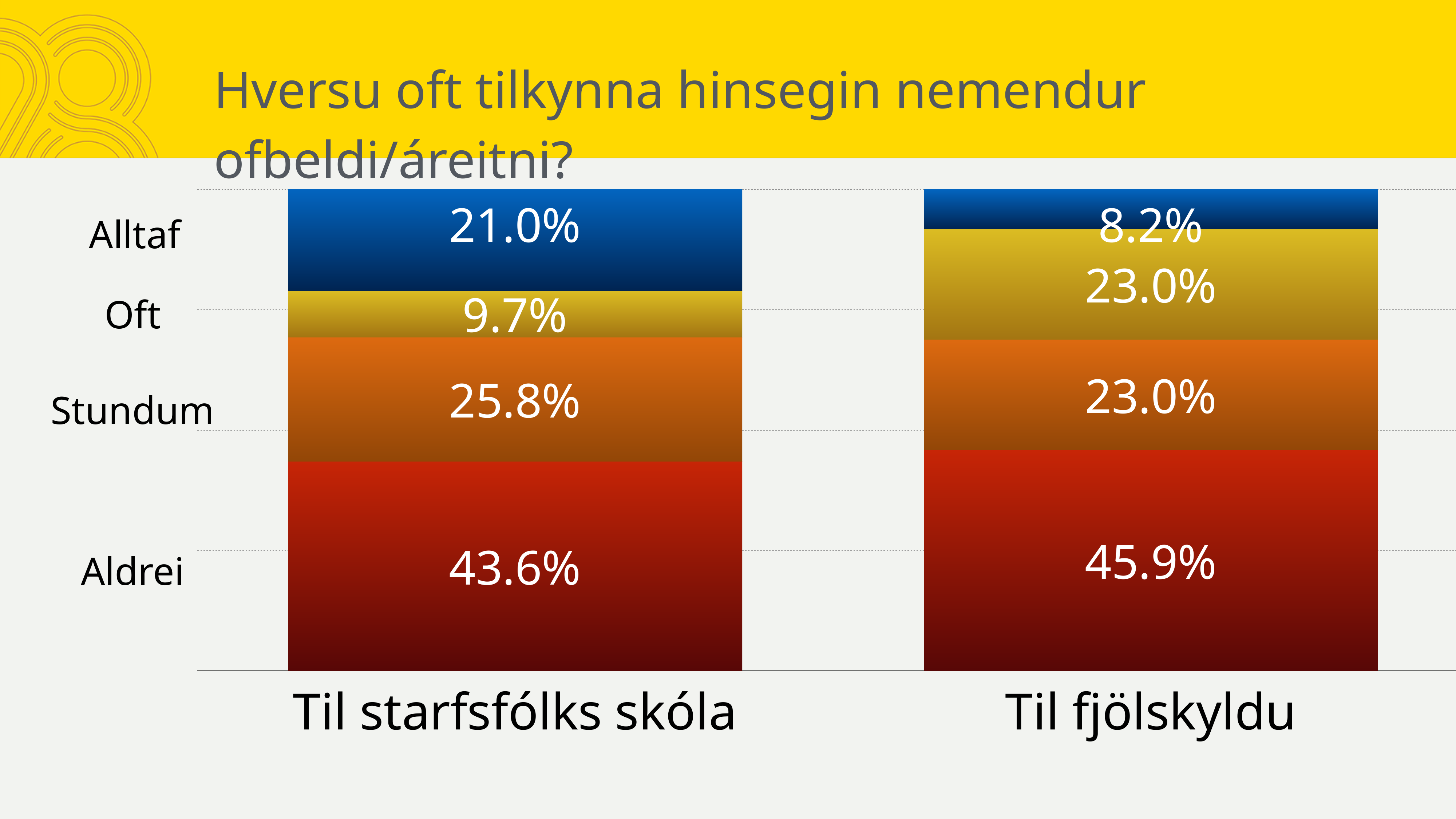
Which bar has the larger Oft value, Til starfsfólks skóla or Til fjölskyldu? Til fjölskyldu What kind of chart is shown on the slide? Stacked bar chart What is the difference between the Aldrei values for Til fjölskyldu and Til starfsfólks skóla? 2.3% What is the value for Aldrei in the Til starfsfólks skóla bar? 43.6% How many series (segments) make up each stacked bar? 4 What is the value for Oft in the Til fjölskyldu bar? 23.0% Which segment is the smallest in the Til starfsfólks skóla bar? Oft What is the value for Alltaf in the Til starfsfólks skóla bar? 21.0% How many bars are shown in the chart? 2 What is the value for Alltaf in the Til fjölskyldu bar? 8.2% What is the difference between the Alltaf values for Til starfsfólks skóla and Til fjölskyldu? 12.8% Which segment is the largest in the Til fjölskyldu bar? Aldrei